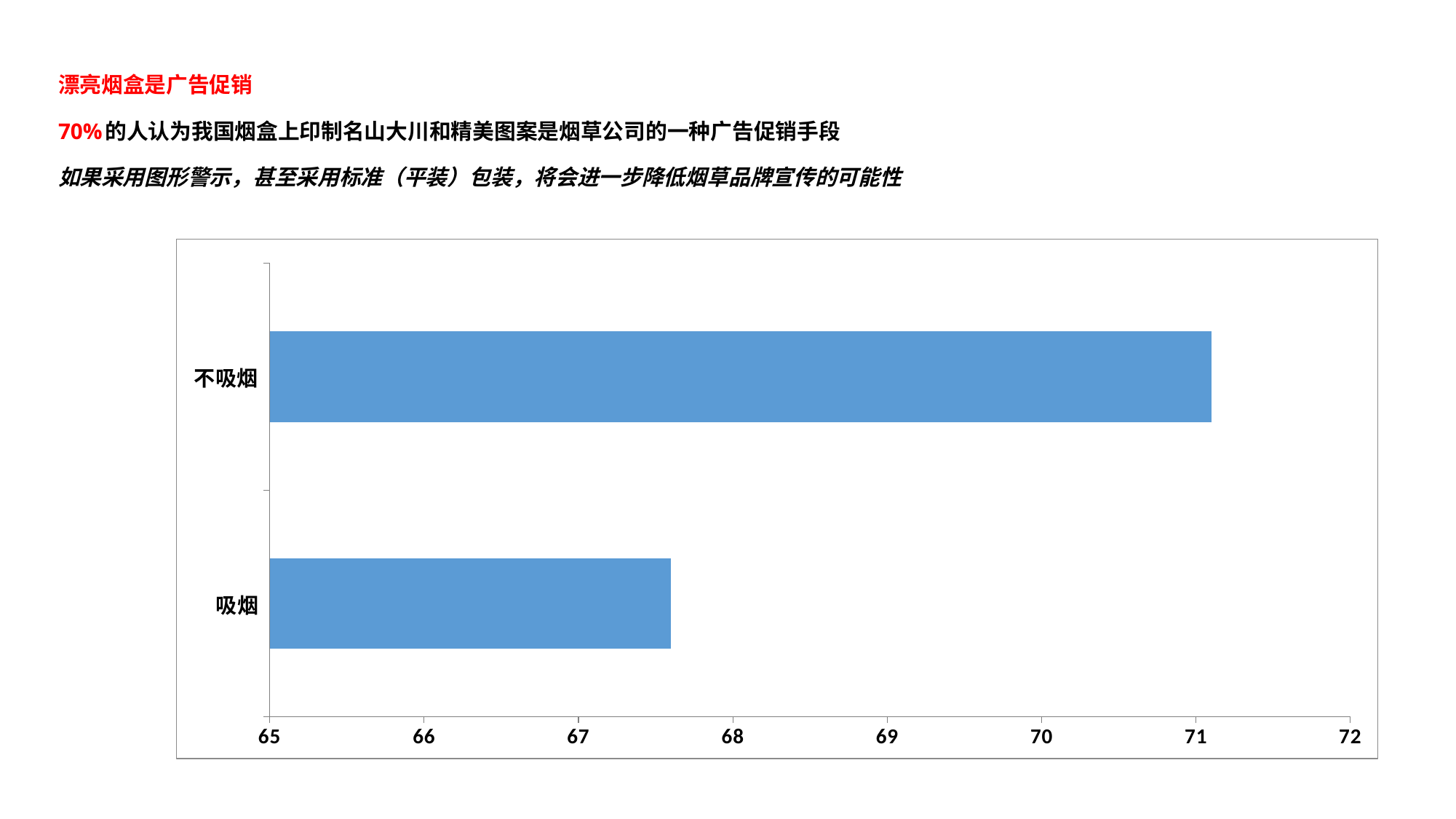
Which category has the lowest value in the bar chart? 吸烟 Is the value for 不吸烟 greater or less than 70? greater What is the highest value shown on the x axis of the bar chart? 72 What kind of chart is shown on the slide? bar chart Which category has the highest value in the bar chart? 不吸烟 Is the value for 不吸烟 greater or less than 72? less How many categories are plotted in the bar chart? 2 Which is larger, the value for 不吸烟 or the value for 吸烟? 不吸烟 Is the value for 吸烟 greater or less than 67? greater What is the lowest value shown on the x axis of the bar chart? 65